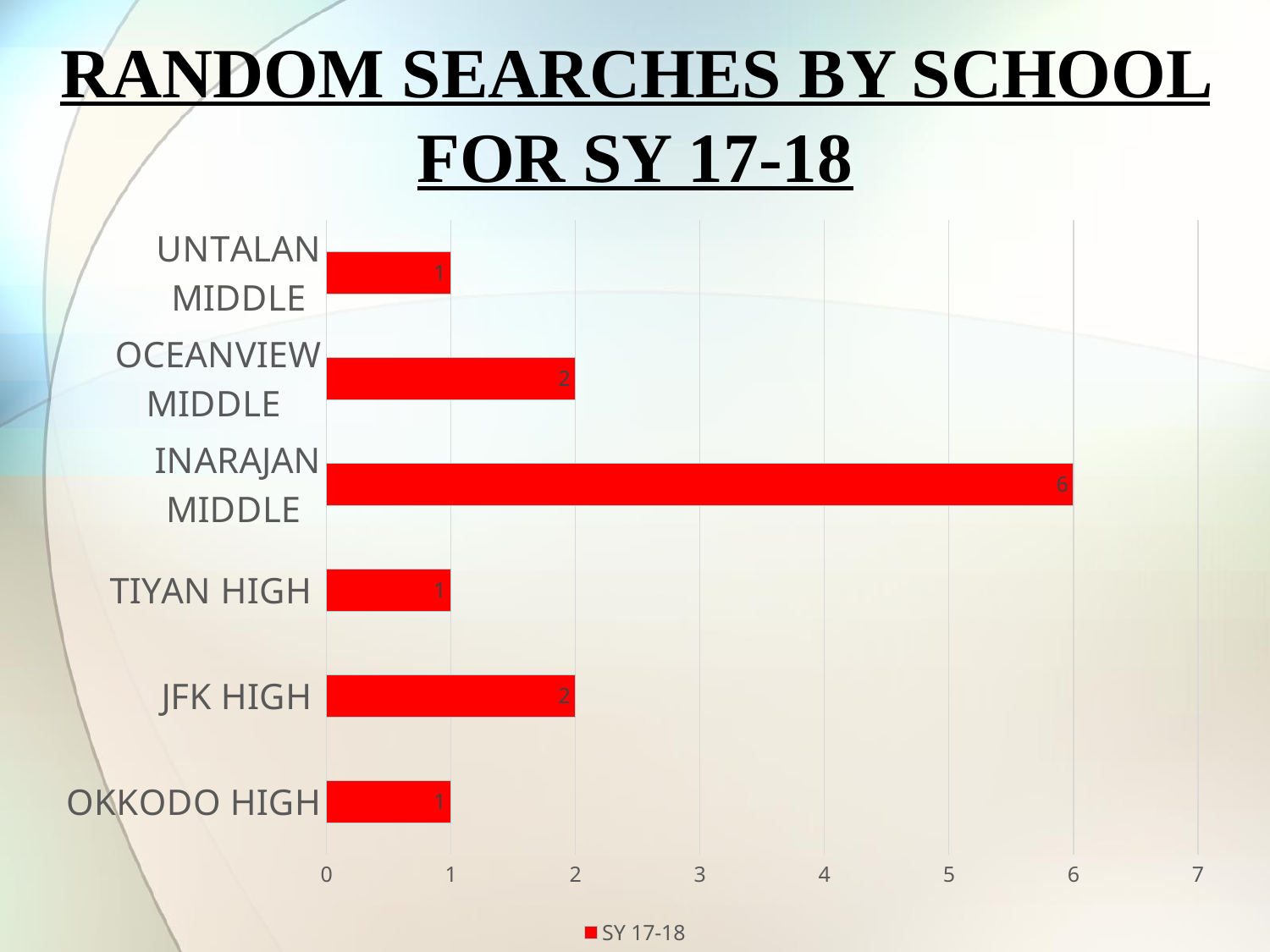
What is the value for INARAJAN MIDDLE? 6 How many series does the legend list? 1 What is the value for OKKODO HIGH? 1 Is the value for INARAJAN MIDDLE greater or less than 5? greater What is the legend entry shown below the chart? SY 17-18 What is the value for OCEANVIEW MIDDLE? 2 Which is larger, the value for OCEANVIEW MIDDLE or the value for TIYAN HIGH? OCEANVIEW MIDDLE What is the difference between the values for INARAJAN MIDDLE and JFK HIGH? 4 What is the title of the chart? RANDOM SEARCHES BY SCHOOL FOR SY 17-18 Which school has the highest number of random searches? INARAJAN MIDDLE How many schools are shown on the chart? 6 What kind of chart is shown on the slide? bar chart